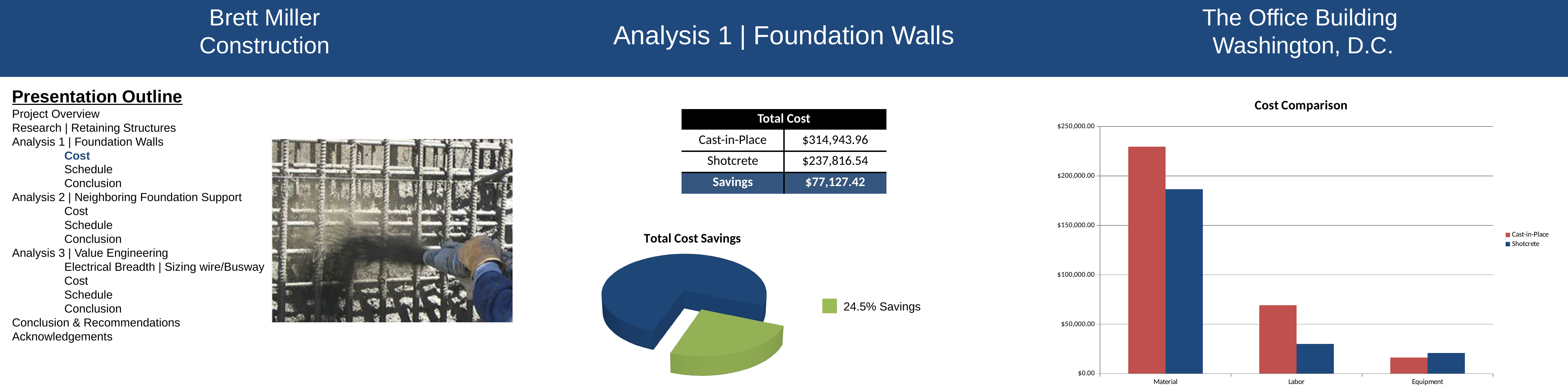
In the Cost Comparison chart, do the Cast-in-Place values rise or fall from Material to Equipment? fall In the Cost Comparison chart, which category has the lowest Shotcrete value? Equipment How many categories are shown on the x axis of the Cost Comparison chart? 3 In the Cost Comparison chart, is the Shotcrete value for Labor greater or less than $50,000.00? less What kind of chart is the Cost Comparison chart? bar chart What kind of chart is the Total Cost Savings chart? pie chart In the Cost Comparison chart, which is larger for Material: Cast-in-Place or Shotcrete? Cast-in-Place In the Cost Comparison chart, is the Cast-in-Place value for Labor greater or less than $50,000.00? greater How many series does the legend of the Cost Comparison chart list? 2 In the Total Cost Savings pie chart, what share does the green slice represent according to the legend? 24.5% Savings In the Cost Comparison chart, which category has the highest Cast-in-Place value? Material In the Cost Comparison chart, is the Cast-in-Place value for Material greater or less than $200,000.00? greater